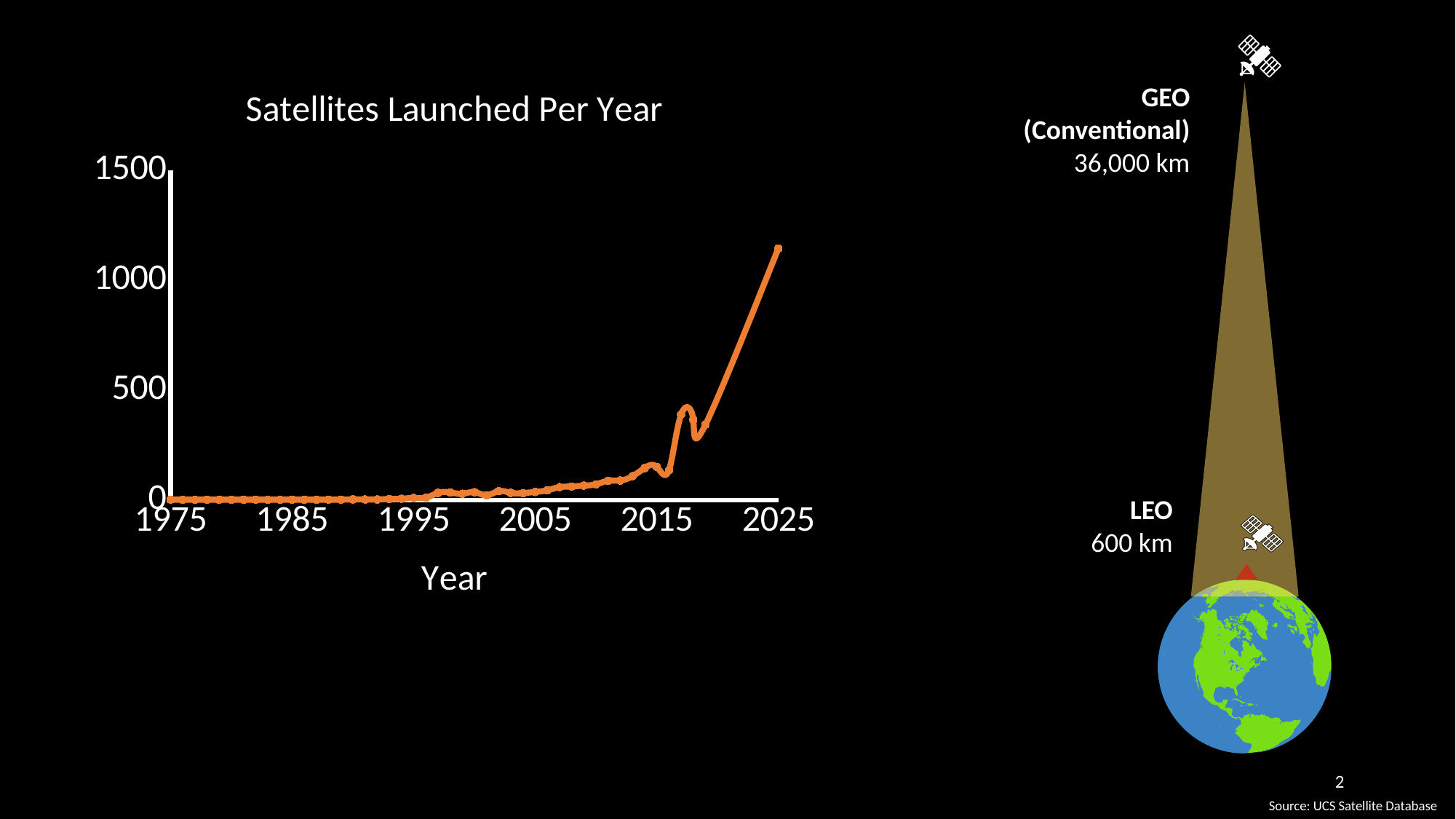
How many year labels are shown on the x axis of the chart? 6 What is the label of the x axis of the chart? Year What kind of chart is shown on the slide? line chart Do the values generally rise or fall from 1975 to 2025? rise Which is larger, the value for 2025 or the value for 2015? 2025 Is the value for 2025 greater or less than 1000? greater Which year has the highest value on the chart? 2025 Is the value for 2015 greater or less than 500? less Is the value for 2005 greater or less than 500? less What is the title of the chart on the slide? Satellites Launched Per Year